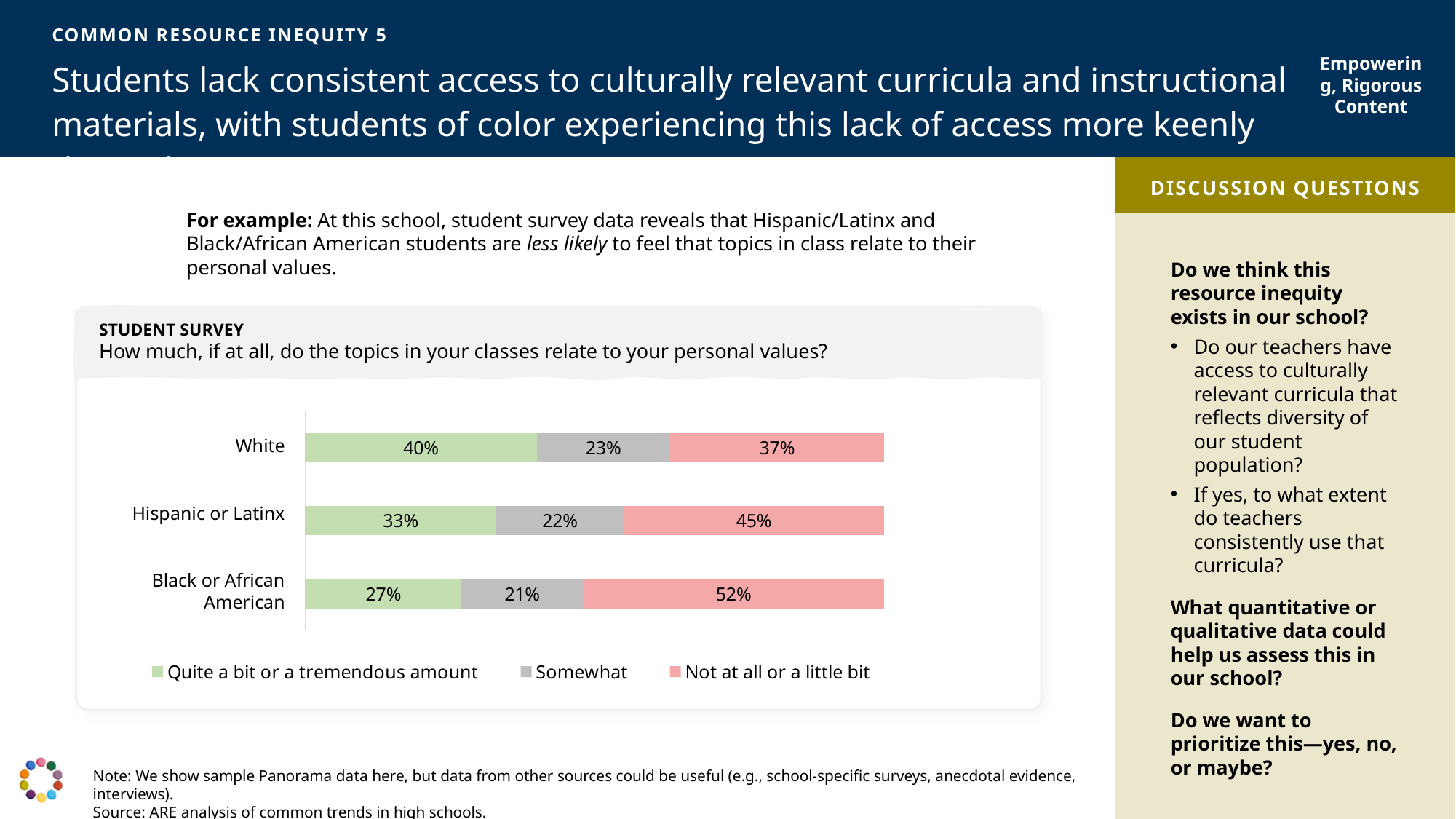
How many series does the legend list? 3 What is the total of the three segments in the Hispanic or Latinx bar? 100% What kind of chart is shown on the slide? Stacked bar chart Which group has the lowest share answering "Quite a bit or a tremendous amount"? Black or African American What is the difference between the "Not at all or a little bit" share for Black or African American students and for White students? 15 percentage points How many student groups are shown in the chart? 3 What percentage of Hispanic or Latinx students answered "Somewhat"? 22% What percentage of Black or African American students answered "Not at all or a little bit"? 52% What percentage of White students answered "Quite a bit or a tremendous amount"? 40% Which group has the highest share answering "Not at all or a little bit"? Black or African American What survey question does the chart show responses to? How much, if at all, do the topics in your classes relate to your personal values? Which is larger: the "Quite a bit or a tremendous amount" share for White students or for Hispanic or Latinx students? White